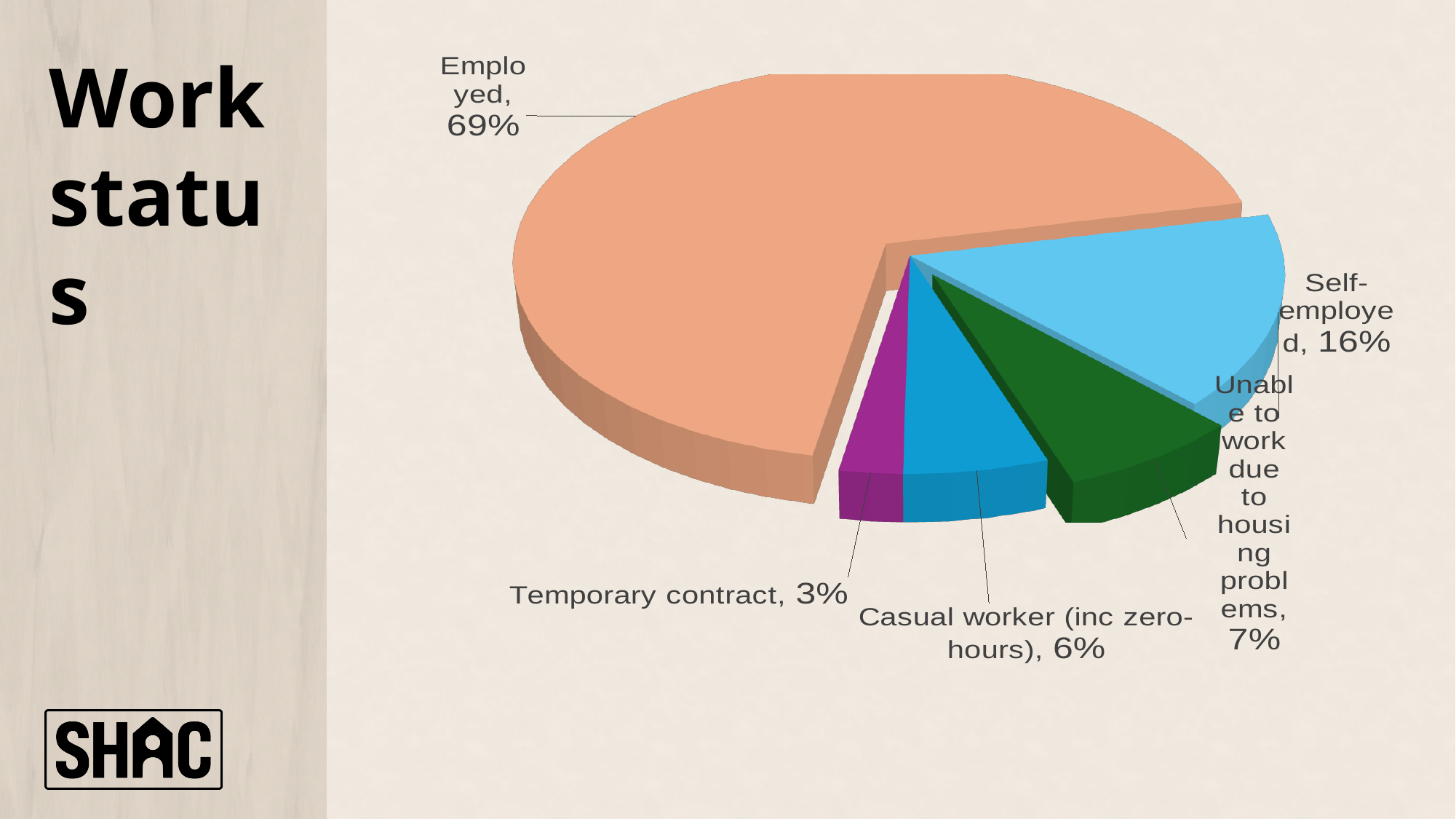
What share of the pie is Temporary contract? 3% How many categories are shown in the pie chart? 5 What share of the pie is Unable to work due to housing problems? 7% Which category has the smallest share of the pie? Temporary contract What is the title of the slide? Work status Which is larger, Casual worker (inc zero-hours) or Temporary contract? Casual worker (inc zero-hours) What share of the pie is Employed? 69% What share of the pie is Casual worker (inc zero-hours)? 6% Which category has the largest share of the pie? Employed What is the difference in percentage points between Employed and Self-employed? 53 What share of the pie is Self-employed? 16% What kind of chart is shown on the slide? Pie chart